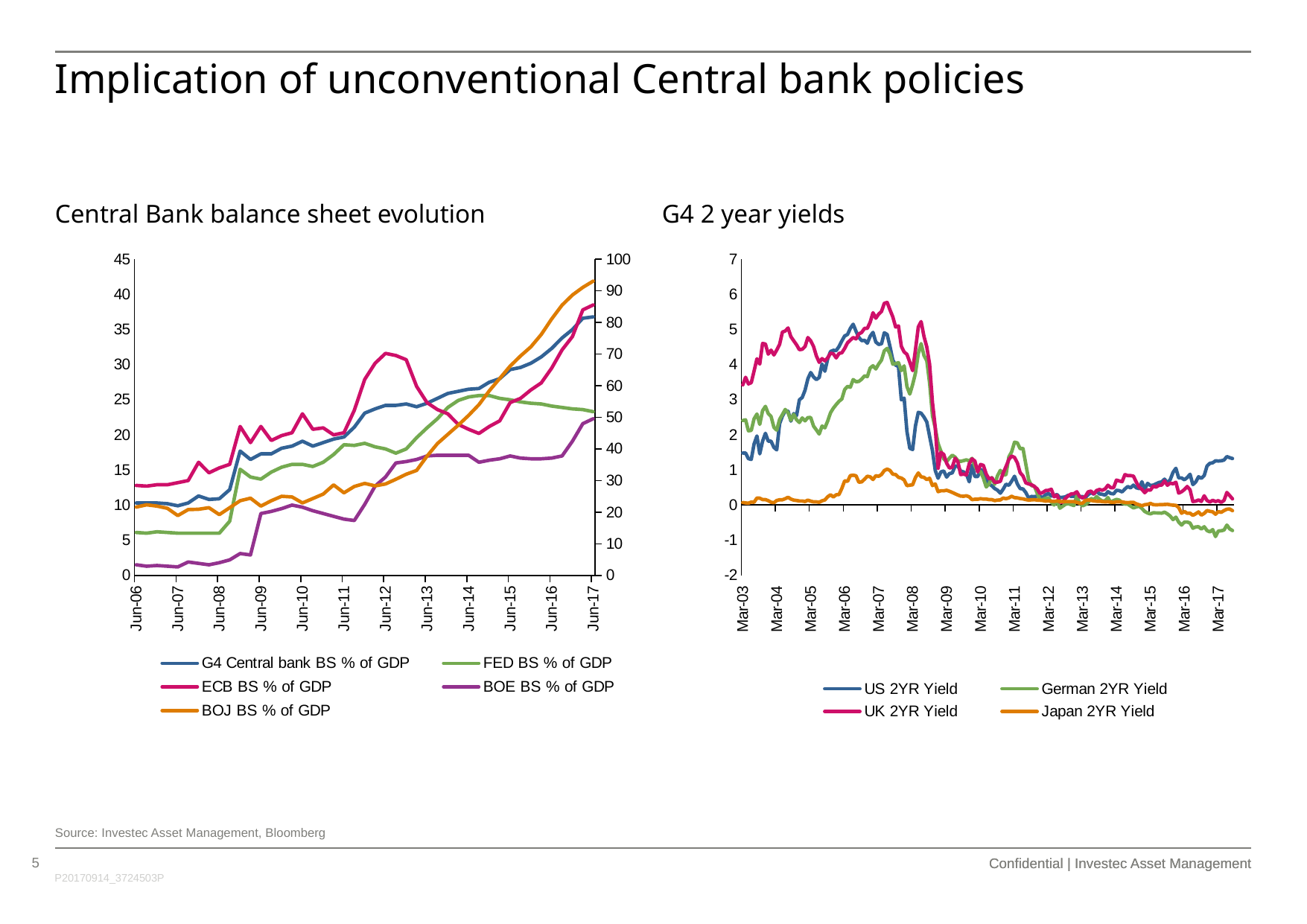
In the 'G4 2 year yields' chart, is the Japan 2YR Yield at Mar-07 greater or less than 2? less In the 'Central Bank balance sheet evolution' chart, does the BOJ BS % of GDP line rise or fall between Jun-13 and Jun-17? rise What kind of chart is the 'Central Bank balance sheet evolution' chart? line chart In the 'G4 2 year yields' chart, is the US 2YR Yield at Mar-17 greater or less than 1? greater What is the title of the chart on the right side of the slide? G4 2 year yields In the 'G4 2 year yields' chart, does the German 2YR Yield rise or fall between Mar-12 and Mar-17? fall In the 'G4 2 year yields' chart, is the German 2YR Yield at Mar-17 greater or less than 0? less How many series does the legend of the 'Central Bank balance sheet evolution' chart list? 5 What kind of chart is the 'G4 2 year yields' chart? line chart How many series does the legend of the 'G4 2 year yields' chart list? 4 In the 'G4 2 year yields' chart, which is higher at Mar-17: the US 2YR Yield or the German 2YR Yield? US 2YR Yield In the 'Central Bank balance sheet evolution' chart, does the FED BS % of GDP line rise or fall between Jun-14 and Jun-17? fall